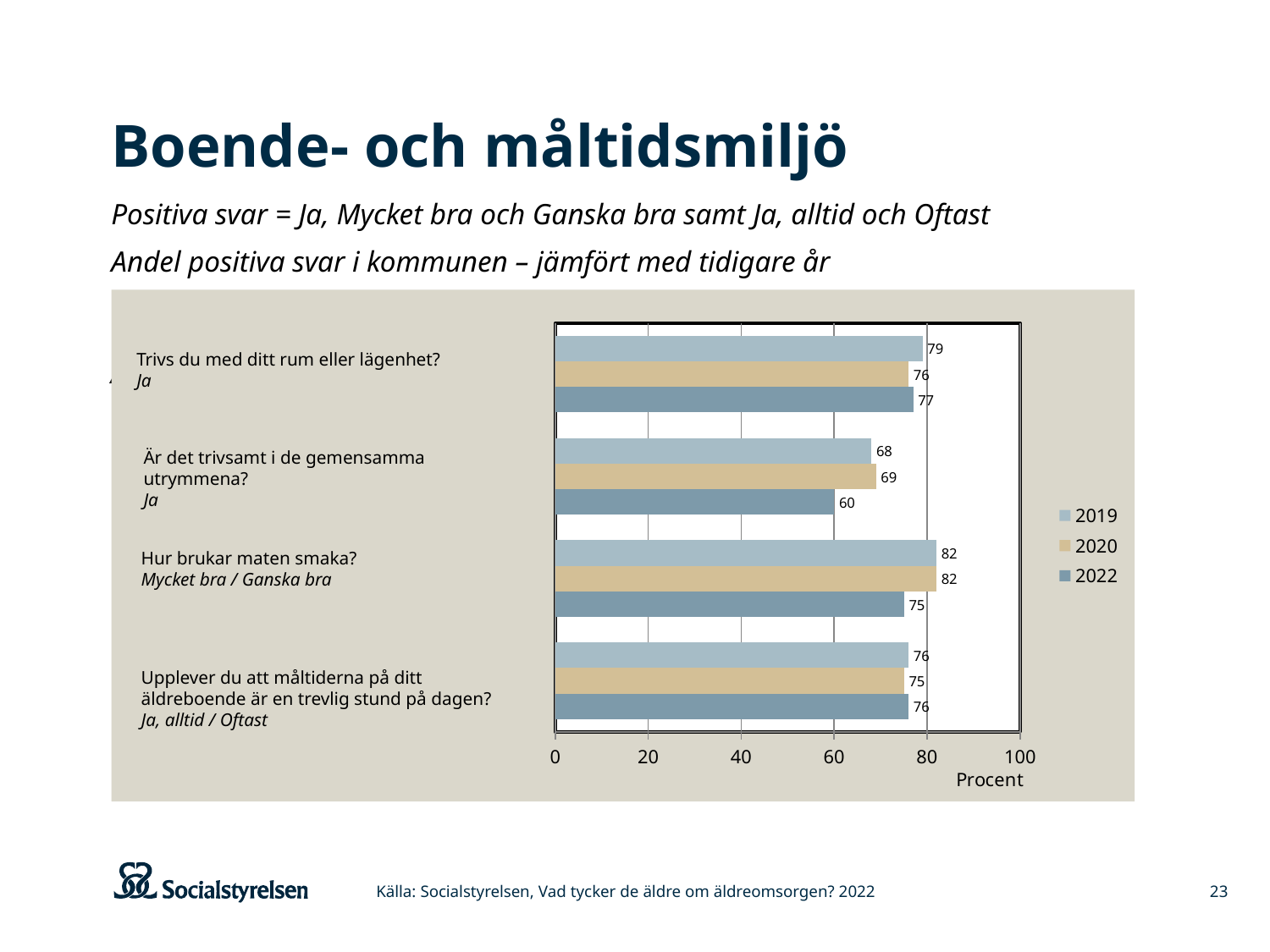
Which survey question has the highest 2019 value? Hur brukar maten smaka? For "Är det trivsamt i de gemensamma utrymmena?", which year has the larger value, 2020 or 2022? 2020 What is the 2022 value for "Är det trivsamt i de gemensamma utrymmena?"? 60 How many survey questions (categories) are plotted in the chart? 4 What is the 2019 value for "Hur brukar maten smaka?"? 82 What is the 2020 value for "Upplever du att måltiderna på ditt äldreboende är en trevlig stund på dagen?"? 75 What kind of chart is shown on the slide? Bar chart What is the label of the x axis? Procent Which survey question has the lowest 2022 value? Är det trivsamt i de gemensamma utrymmena? How many series does the legend list? 3 What is the 2022 value for "Trivs du med ditt rum eller lägenhet?"? 77 What is the difference between the 2020 and 2022 values for "Hur brukar maten smaka?"? 7